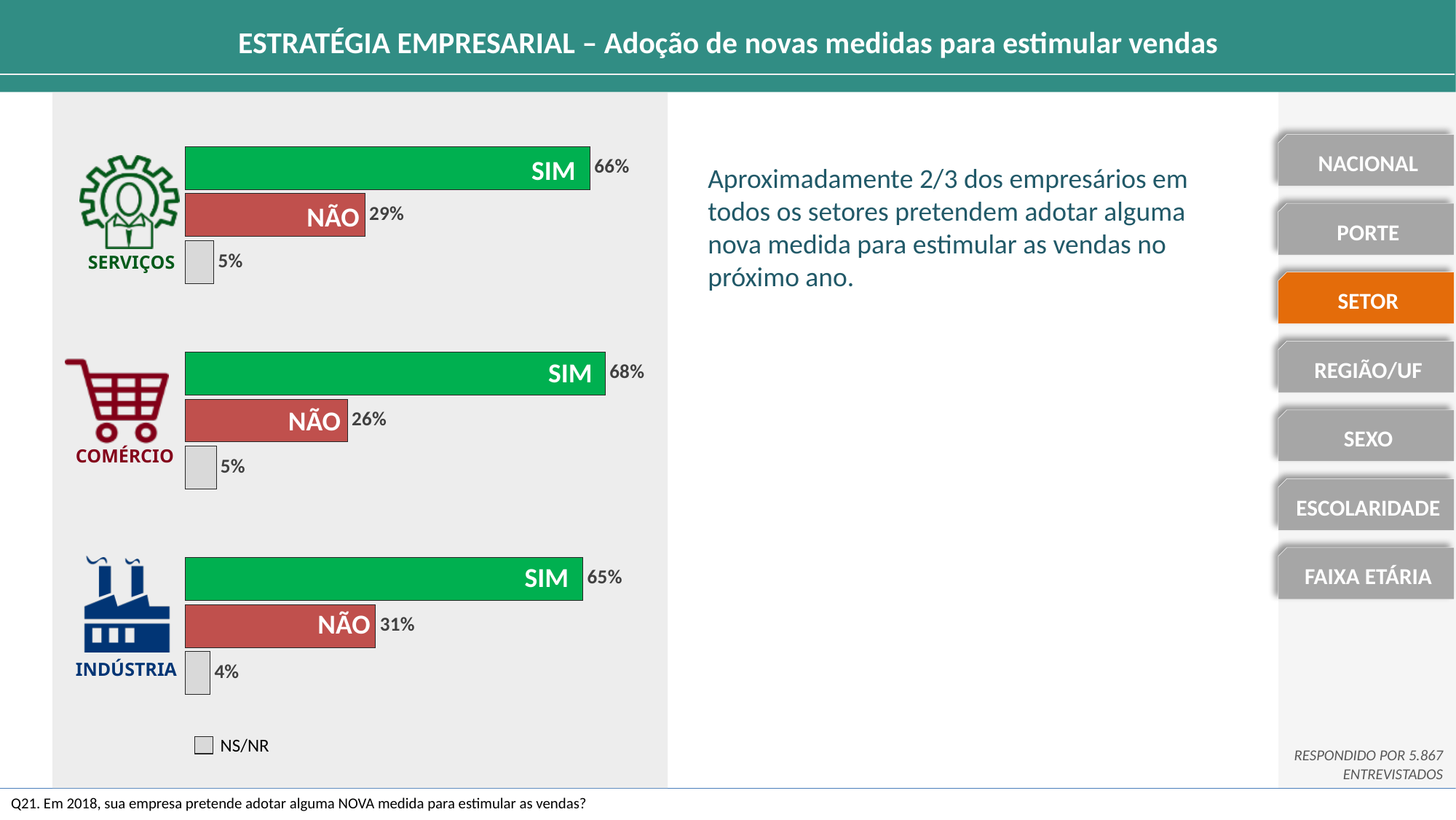
What label does the legend give to the grey bars? NS/NR In the INDÚSTRIA chart, what is the difference between the SIM and NÃO percentages? 34% In the INDÚSTRIA chart, what percentage is shown for NS/NR? 4% What type of chart is used to show the responses for each sector? Bar chart How many response categories (bars) are shown for each sector? 3 In the SERVIÇOS chart, what percentage answered SIM? 66% Across the three sector charts, which sector has the lowest NÃO percentage? COMÉRCIO Which is larger: the NÃO percentage for SERVIÇOS or the NÃO percentage for INDÚSTRIA? INDÚSTRIA What is the total of the SIM, NÃO and NS/NR percentages for SERVIÇOS? 100% Across the three sector charts, which sector has the highest SIM percentage? COMÉRCIO How many sectors are shown on the slide? 3 In the COMÉRCIO chart, what percentage answered NÃO? 26%